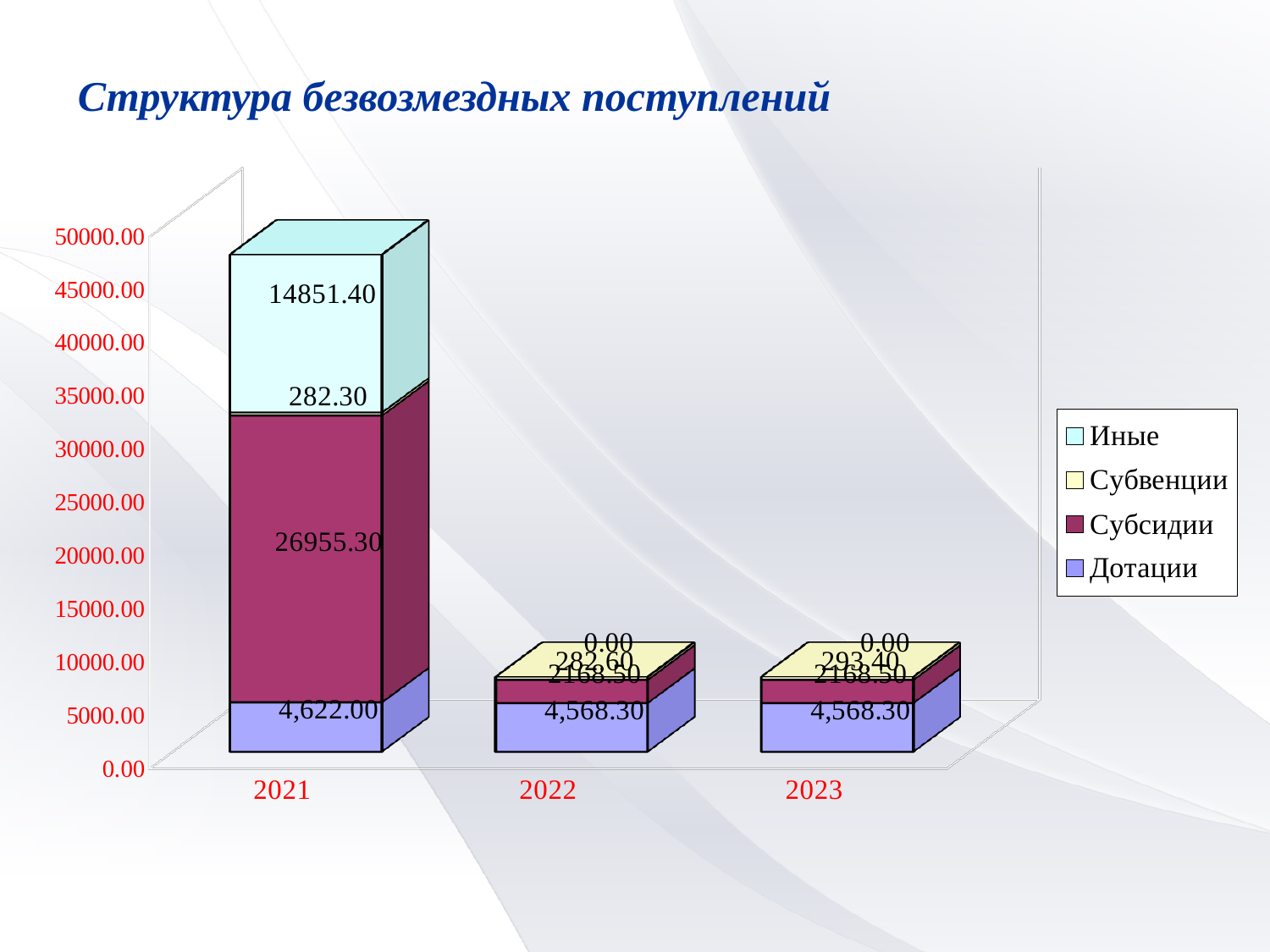
What is the value of Дотации for 2022? 4,568.30 What is the value of Субсидии for 2021? 26955.30 What is the value of Иные for 2021? 14851.40 How many series does the legend list? 4 Is the total of the 2021 stacked bar greater or less than 40000.00? greater What is the value of Субвенции for 2023? 293.40 How many years (categories) are shown on the x axis? 3 What kind of chart is shown on the slide? Stacked bar chart Which year has the highest total stacked bar? 2021 Which is larger: Дотации in 2021 or Дотации in 2022? Дотации in 2021 What is the title of the chart? Структура безвозмездных поступлений What is the difference between Субсидии in 2021 and Субсидии in 2022? 24786.80